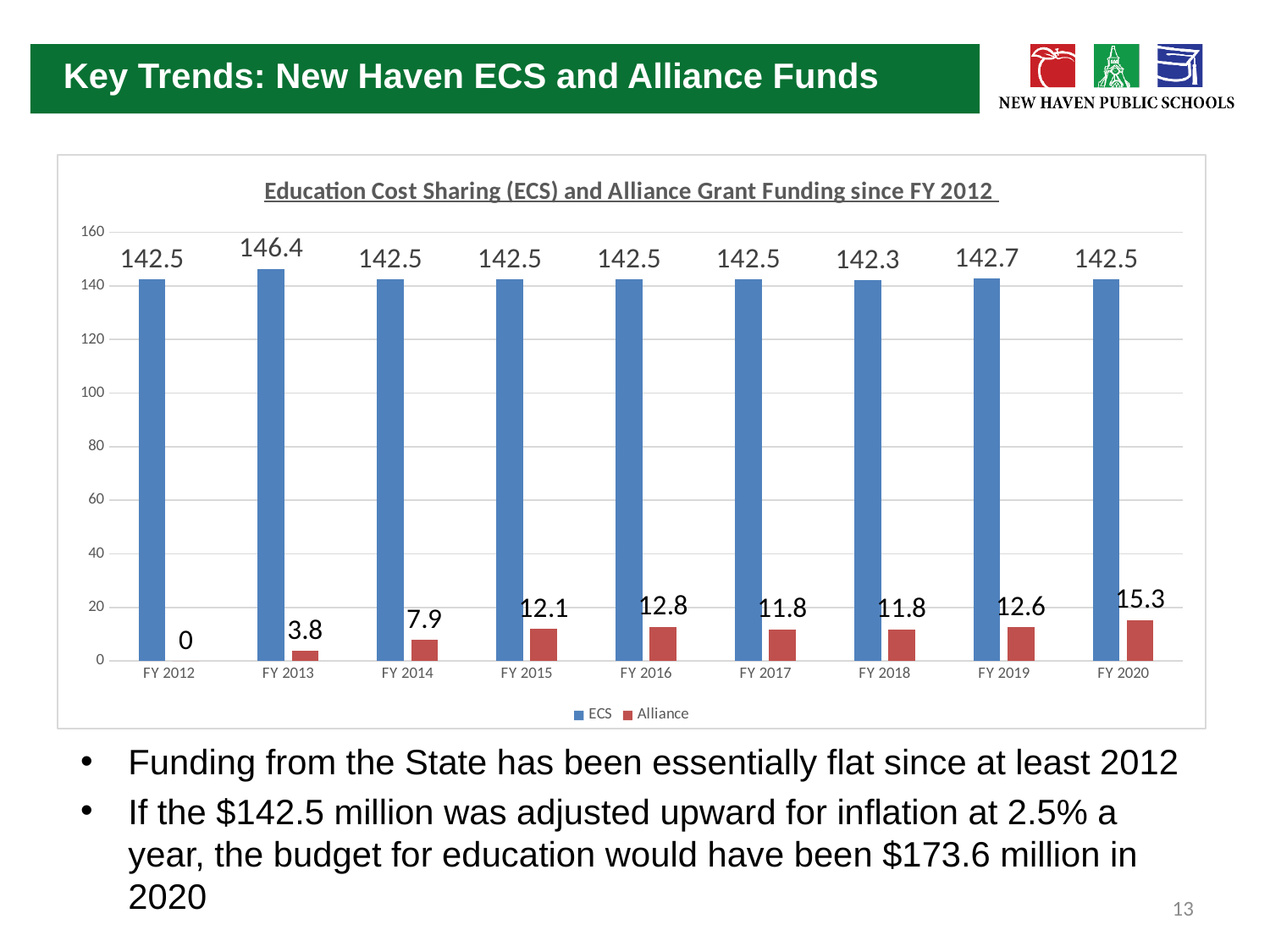
What kind of chart is shown on the slide? Bar chart What is the Alliance value for FY 2020? 15.3 What is the ECS value for FY 2013? 146.4 What is the difference between the Alliance values for FY 2020 and FY 2013? 11.5 Which fiscal year has the highest ECS value? FY 2013 Which is larger, the Alliance value for FY 2016 or for FY 2017? FY 2016 Does the Alliance value rise or fall from FY 2012 to FY 2016? Rise What is the title of the chart? Education Cost Sharing (ECS) and Alliance Grant Funding since FY 2012 Which fiscal year has the lowest Alliance value? FY 2012 How many fiscal years are shown on the x axis? 9 What is the Alliance value for FY 2014? 7.9 How many series does the legend list? 2